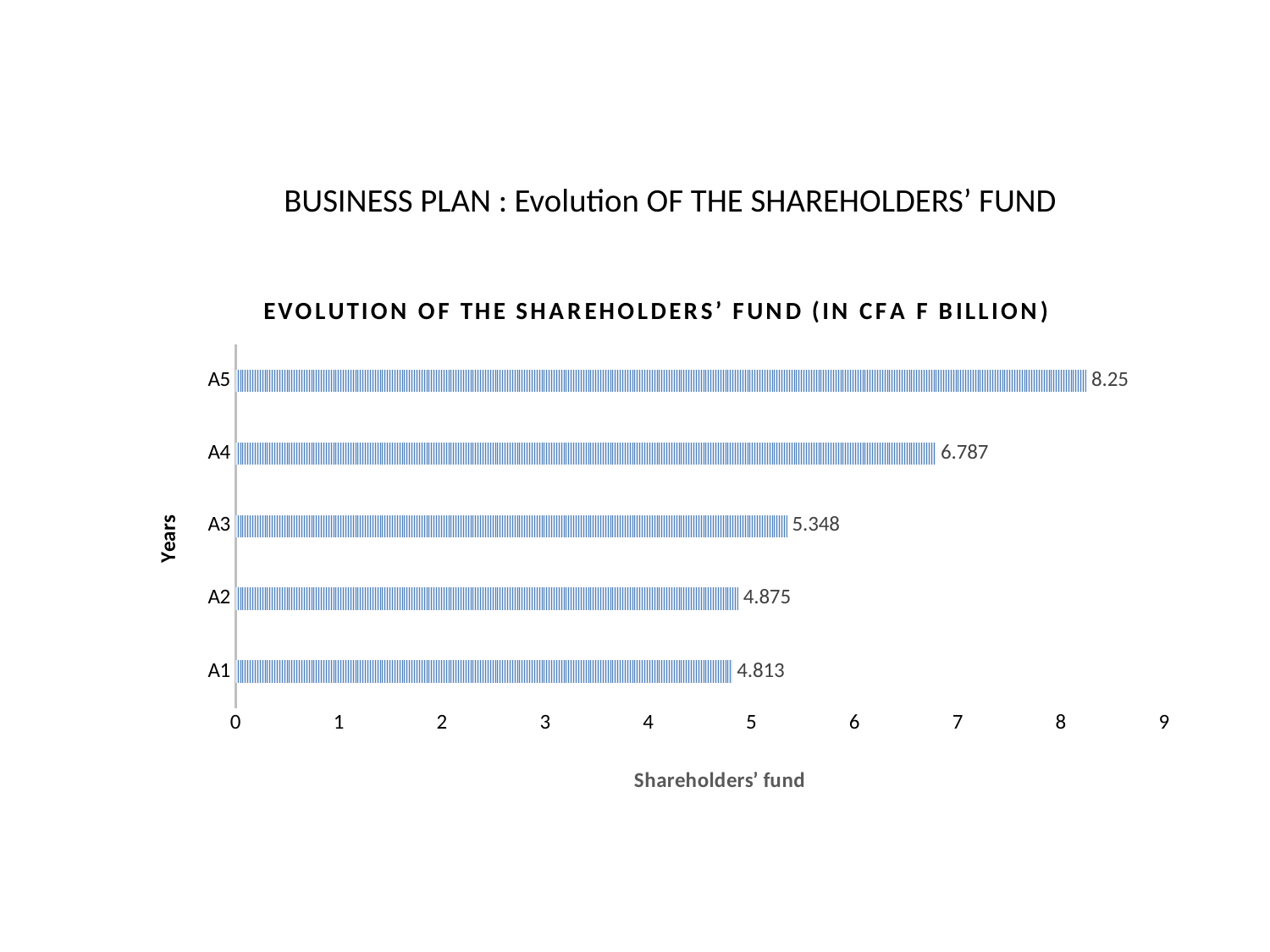
Which is larger, the shareholders' fund for A4 or for A3? A4 What kind of chart is shown on the slide? Bar chart What is the difference between the shareholders' fund for A2 and A1? 0.062 Which year has the highest shareholders' fund? A5 Which year has the lowest shareholders' fund? A1 What is the shareholders' fund value for A5? 8.25 What is the shareholders' fund value for A3? 5.348 What is the shareholders' fund value for A1? 4.813 How many years are shown on the chart? 5 Is the value for A4 greater or less than 6? greater What is the title of the chart? EVOLUTION OF THE SHAREHOLDERS' FUND (IN CFA F BILLION) What is the difference between the shareholders' fund for A5 and A4? 1.463